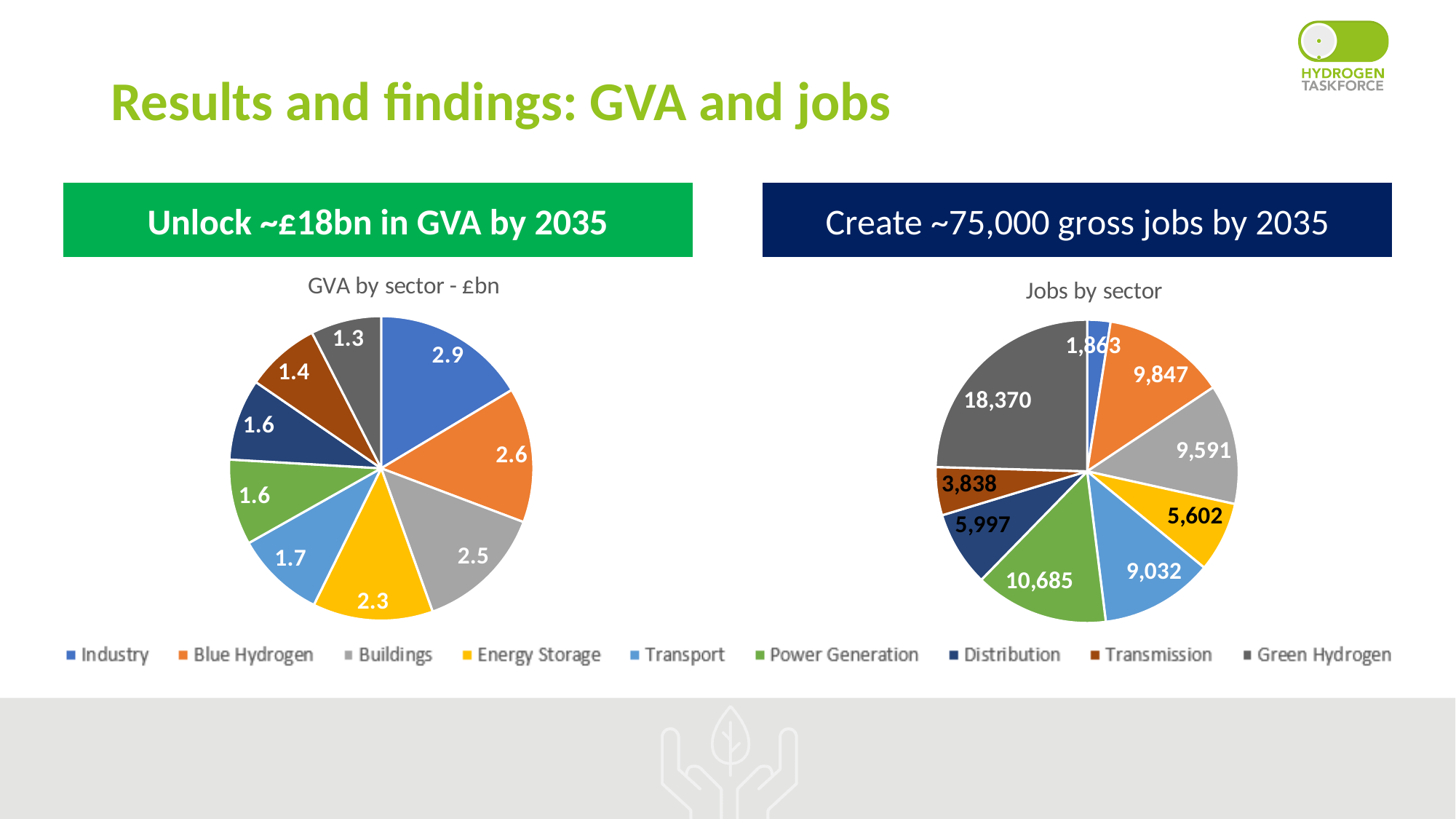
In the 'Jobs by sector' chart, what is the difference between Green Hydrogen and Industry? 16,507 In the 'GVA by sector - £bn' chart, what is the value for Energy Storage? 2.3 In the 'Jobs by sector' chart, which is larger: Buildings or Transport? Buildings In the 'Jobs by sector' chart, how many jobs are shown for Power Generation? 10,685 What kind of chart is the 'GVA by sector - £bn' chart? pie chart In the 'GVA by sector - £bn' chart, what is the difference between Industry and Blue Hydrogen? 0.3 In the 'GVA by sector - £bn' chart, what is the value for Industry? 2.9 In the 'GVA by sector - £bn' chart, which sector has the lowest value? Green Hydrogen In the 'Jobs by sector' chart, which sector has the highest number of jobs? Green Hydrogen How many sectors does the legend list? 9 In the 'Jobs by sector' chart, which sector has the lowest number of jobs? Industry In the 'Jobs by sector' chart, how many jobs are shown for Transmission? 3,838